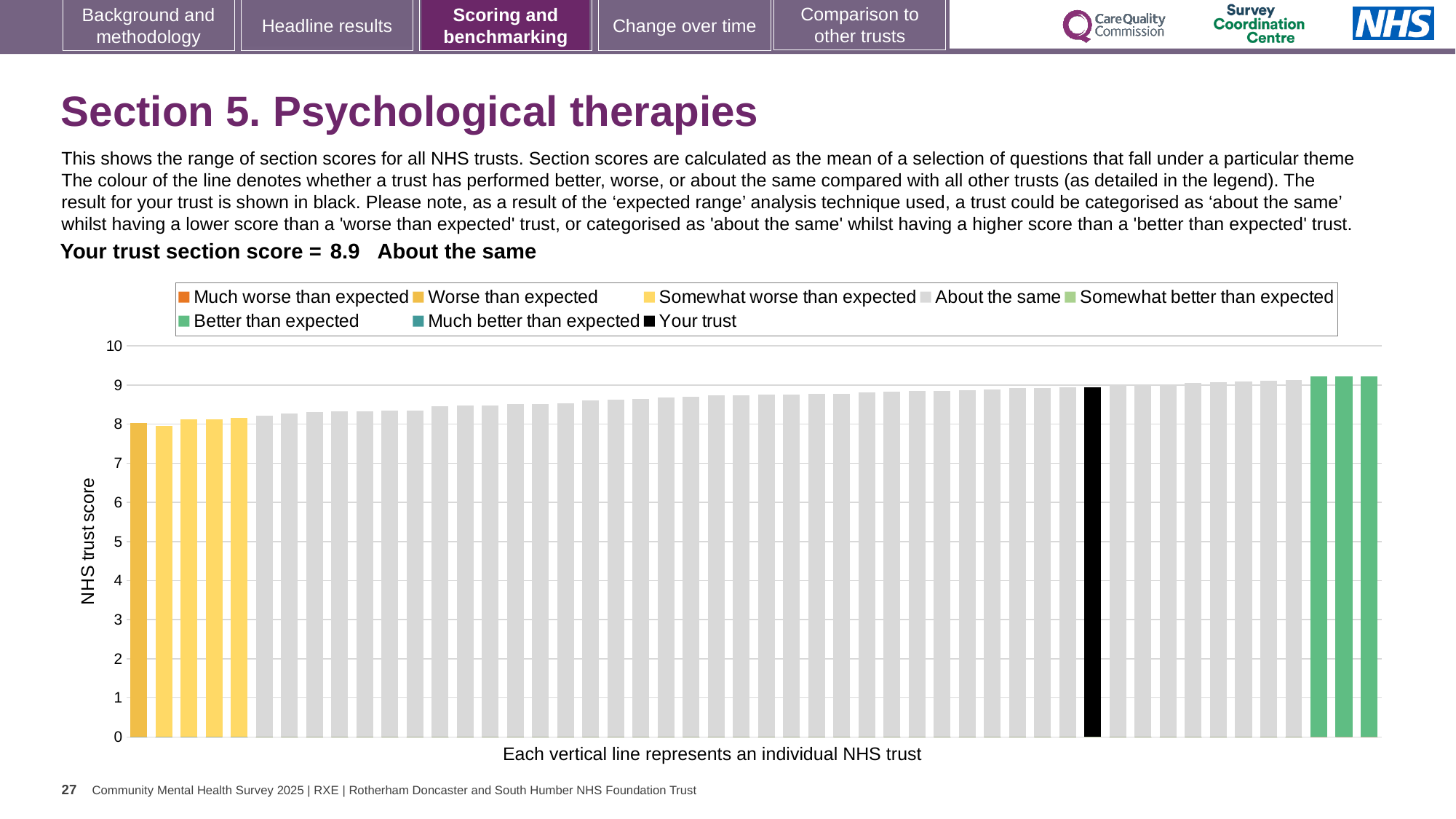
What is the label on the vertical axis? NHS trust score How many bars are coloured green (better than expected)? 3 Which category is your trust placed in for this section? About the same Is the value for the highest bar greater or less than 9? greater How many entries does the chart legend list? 8 What kind of chart is shown on the slide? bar chart What colour is the bar representing your trust? black Is the value for your trust greater or less than 8? greater Is the value for the lowest bar greater or less than 9? less Do the bar values rise or fall from left to right along the x axis? rise What is the section score for your trust? 8.9